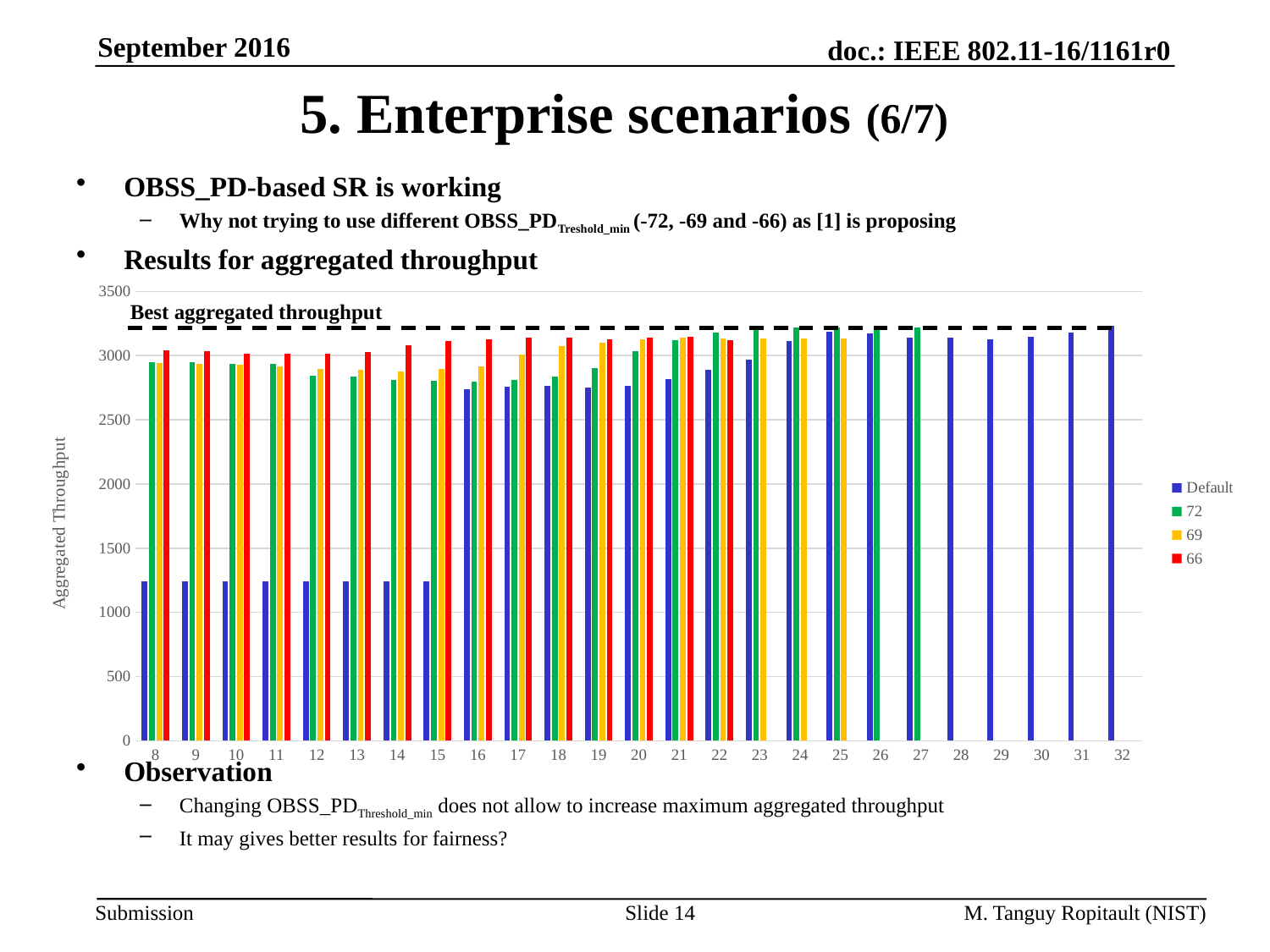
At category 8, which is larger: the Default series or the 66 series? 66 Is the value of the Default series at category 32 greater or less than 3000? greater What kind of chart is shown on the slide? bar chart How many categories are shown along the x axis? 25 Is the value of the 69 series at category 14 greater or less than 3000? less What is the label of the y axis? Aggregated Throughput At category 8, which series has the highest value? 66 Do the values of the Default series rise or fall as the x axis goes from 8 to 32? rise How many series does the legend list? 4 Is the value of the Default series at category 8 greater or less than 1500? less Which series are listed in the legend? Default, 72, 69, 66